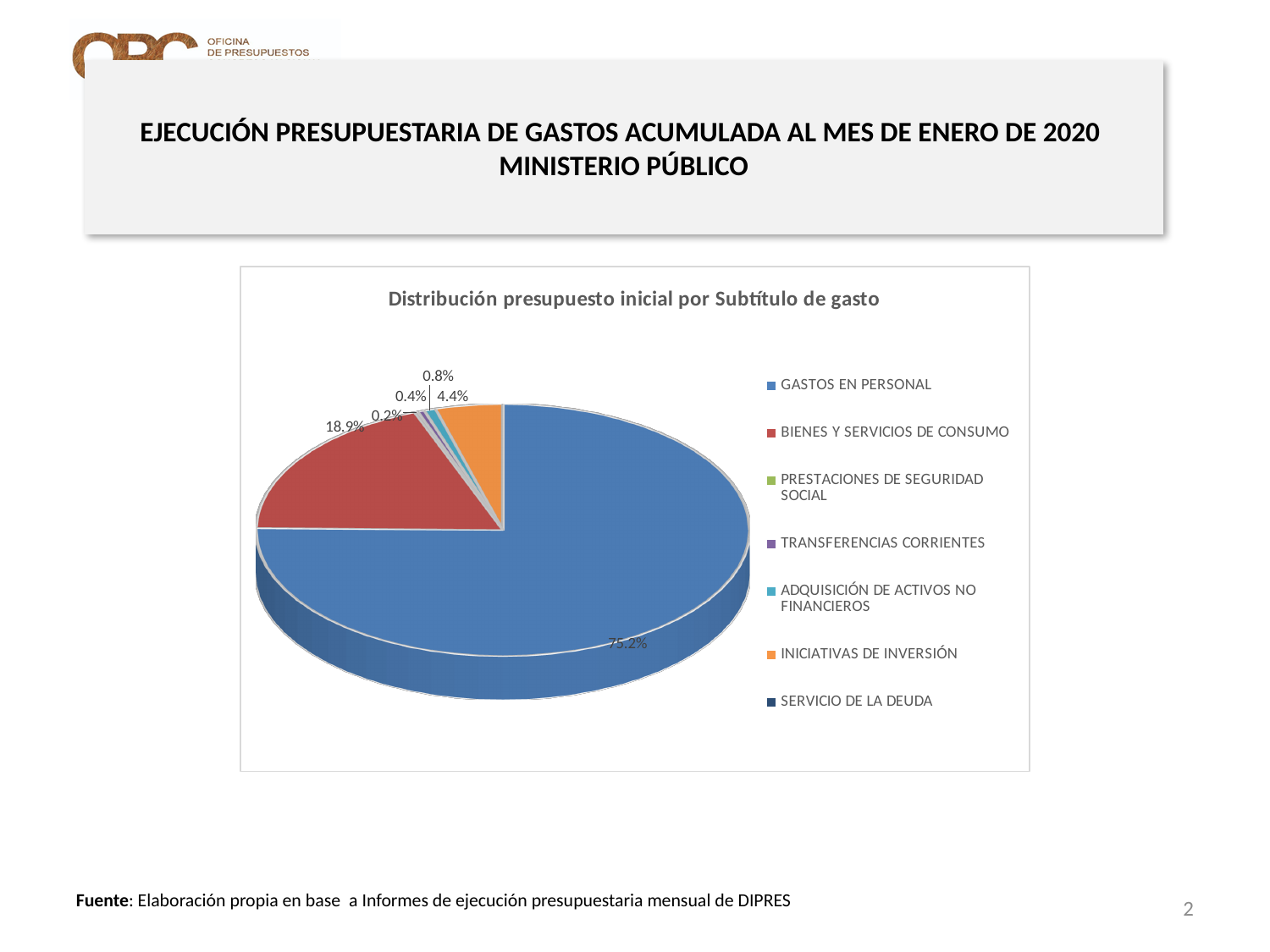
What colour is the slice for GASTOS EN PERSONAL? Blue How many categories does the legend list? 7 What is the title of the chart? Distribución presupuesto inicial por Subtítulo de gasto What is the difference in percentage points between the share for GASTOS EN PERSONAL and the share for BIENES Y SERVICIOS DE CONSUMO? 56.3 What is the combined share of GASTOS EN PERSONAL and BIENES Y SERVICIOS DE CONSUMO? 94.1% Which is larger, the share for BIENES Y SERVICIOS DE CONSUMO or the share for INICIATIVAS DE INVERSIÓN? BIENES Y SERVICIOS DE CONSUMO What type of chart is shown on the slide? Pie chart What share of the pie does BIENES Y SERVICIOS DE CONSUMO represent? 18.9% What is the smallest percentage label shown on the pie? 0.2% What share of the pie does GASTOS EN PERSONAL represent? 75.2% What share of the pie does INICIATIVAS DE INVERSIÓN represent? 4.4% Which category has the largest share of the pie? GASTOS EN PERSONAL